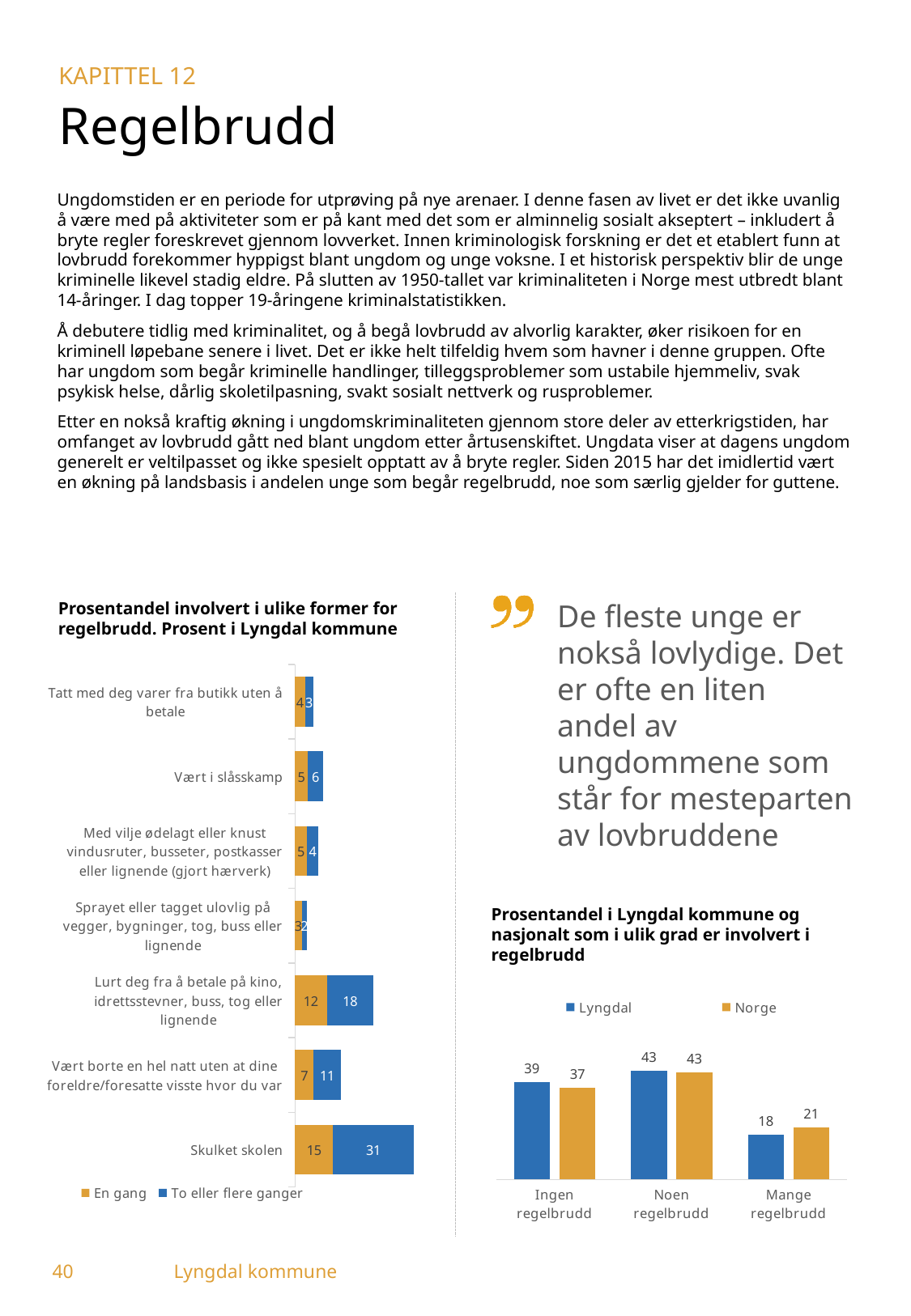
In the chart 'Prosentandel involvert i ulike former for regelbrudd. Prosent i Lyngdal kommune', which category has the highest total? Skulket skolen In the chart 'Prosentandel i Lyngdal kommune og nasjonalt som i ulik grad er involvert i regelbrudd', what is the value for Lyngdal for 'Ingen regelbrudd'? 39 In the chart 'Prosentandel involvert i ulike former for regelbrudd. Prosent i Lyngdal kommune', what is the value for 'To eller flere ganger' for 'Skulket skolen'? 31 What kind of chart is 'Prosentandel i Lyngdal kommune og nasjonalt som i ulik grad er involvert i regelbrudd'? Bar chart In the chart 'Prosentandel involvert i ulike former for regelbrudd. Prosent i Lyngdal kommune', what is the total of the stacked bar for 'Vært borte en hel natt uten at dine foreldre/foresatte visste hvor du var'? 18 In the chart 'Prosentandel involvert i ulike former for regelbrudd. Prosent i Lyngdal kommune', how many categories are shown? 7 In the chart 'Prosentandel i Lyngdal kommune og nasjonalt som i ulik grad er involvert i regelbrudd', what is the difference between Norge and Lyngdal for 'Mange regelbrudd'? 3 In the chart 'Prosentandel involvert i ulike former for regelbrudd. Prosent i Lyngdal kommune', what is the value for 'En gang' for 'Lurt deg fra å betale på kino, idrettsstevner, buss, tog eller lignende'? 12 In the chart 'Prosentandel involvert i ulike former for regelbrudd. Prosent i Lyngdal kommune', what is the total of the stacked bar for 'Skulket skolen'? 46 In the chart 'Prosentandel i Lyngdal kommune og nasjonalt som i ulik grad er involvert i regelbrudd', which is larger for 'Ingen regelbrudd', Lyngdal or Norge? Lyngdal In the chart 'Prosentandel i Lyngdal kommune og nasjonalt som i ulik grad er involvert i regelbrudd', what is the value for Norge for 'Mange regelbrudd'? 21 In the chart 'Prosentandel involvert i ulike former for regelbrudd. Prosent i Lyngdal kommune', how many series does the legend list? 2